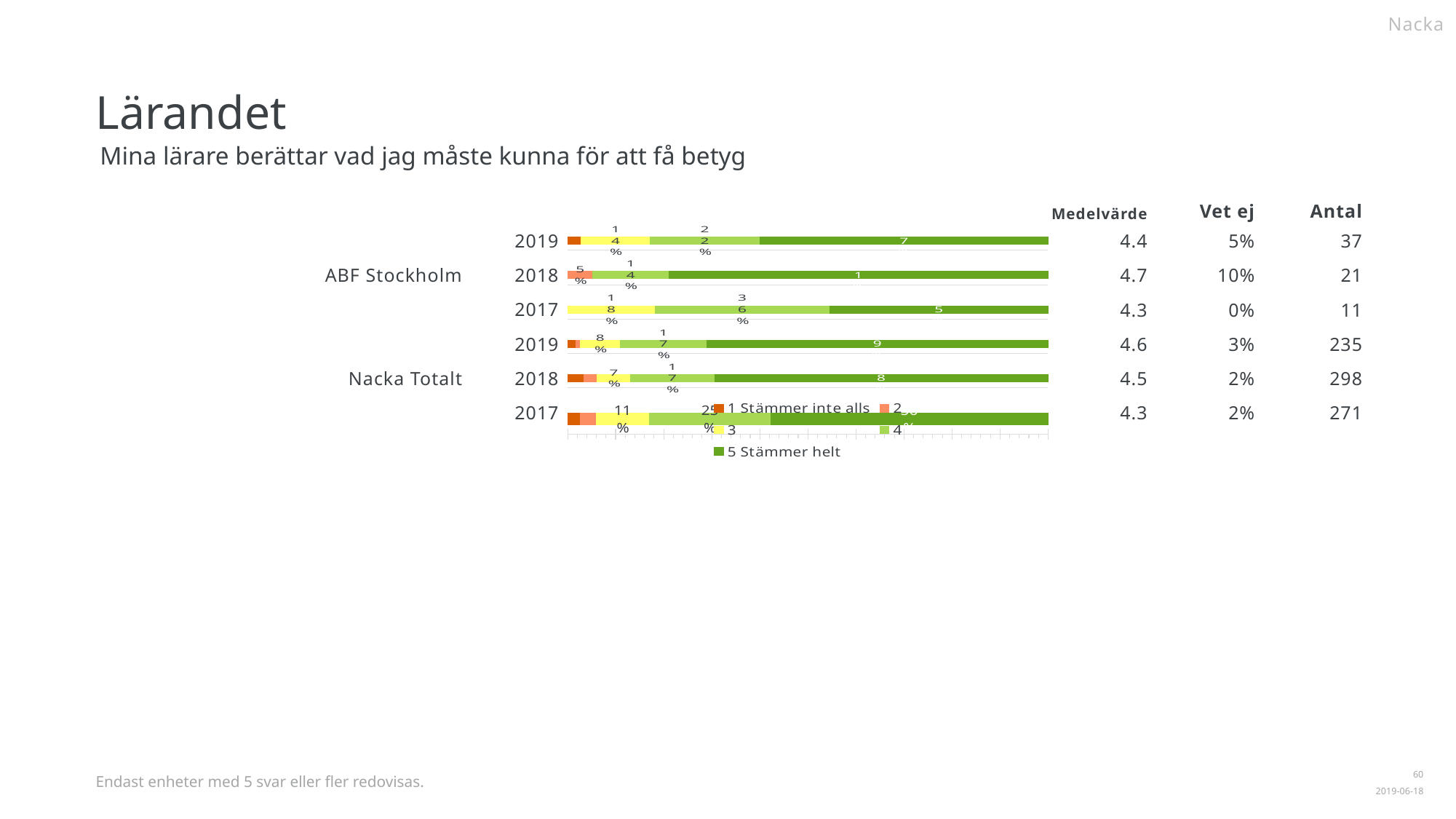
How many series does the chart legend list? 5 Which bar has the smallest '5 Stämmer helt' segment? ABF Stockholm 2017 Which legend entry is shown in dark green? 5 Stämmer helt How many bars are plotted in the chart? 6 What is the value of the '3' segment for Nacka Totalt 2017? 11% What is the value of the '3' segment for ABF Stockholm 2017? 18% What is the value of the '4' segment for ABF Stockholm 2017? 36% What kind of chart is shown on the slide? stacked bar chart What is the value of the '4' segment for Nacka Totalt 2017? 25% Which bar has the largest '5 Stämmer helt' segment? ABF Stockholm 2018 Is the '5 Stämmer helt' segment larger for ABF Stockholm 2018 or for ABF Stockholm 2017? ABF Stockholm 2018 Which legend entry is shown in dark orange? 1 Stämmer inte alls